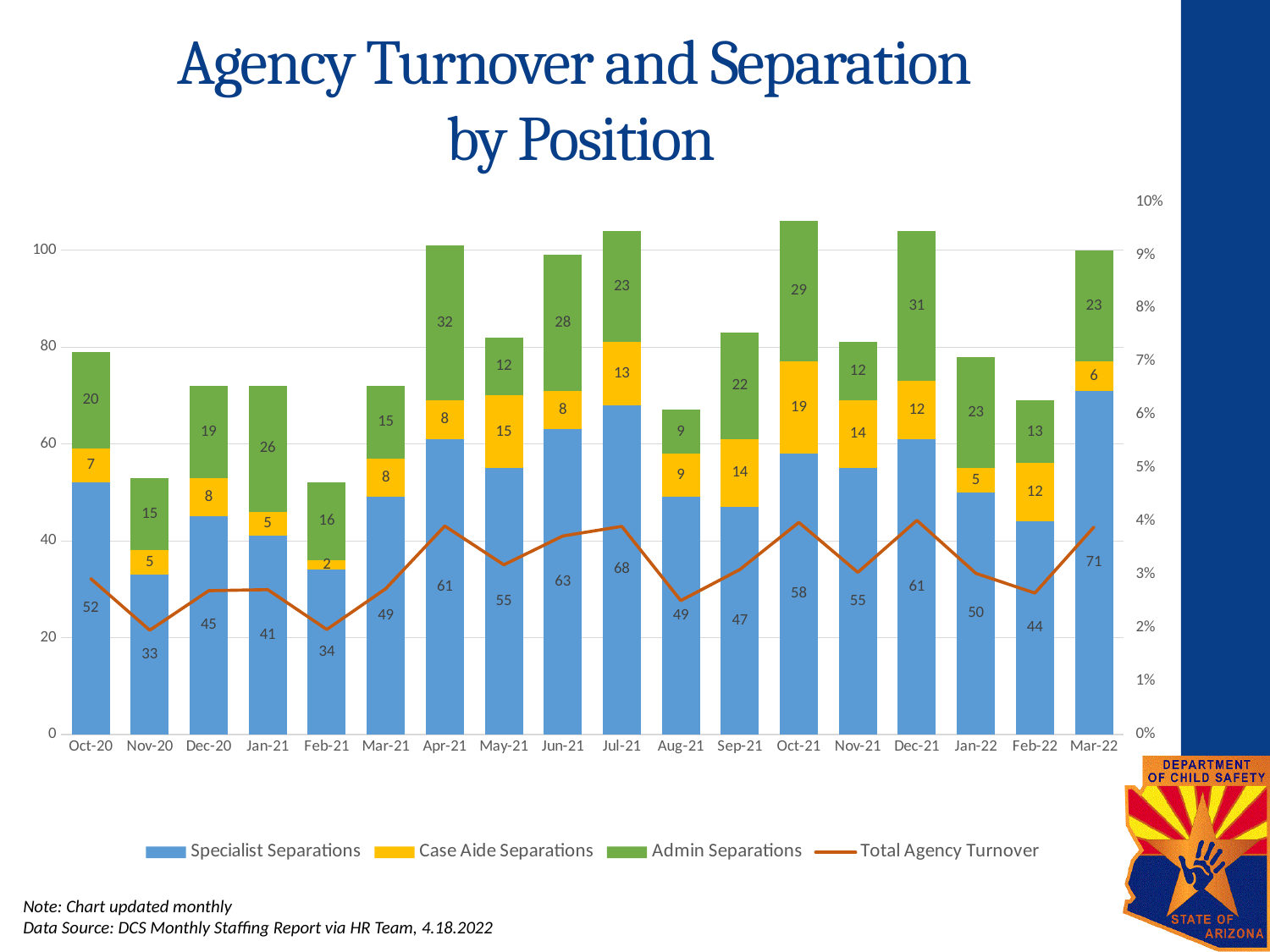
Is the Total Agency Turnover for Nov-20 greater or less than 3%? less Which month has the lowest Specialist Separations? Nov-20 What is the difference between Specialist Separations in Jul-21 and Aug-21? 19 What is the value of Admin Separations for Apr-21? 32 What is the value of Case Aide Separations for Oct-21? 19 What is the value of Specialist Separations for Mar-22? 71 What kind of chart is this? Stacked bar chart with a line Which month has the lowest Case Aide Separations? Feb-21 How many months are shown on the x axis? 18 Which is larger, Admin Separations in Jan-21 or Admin Separations in Dec-20? Jan-21 How many series does the legend list? 4 What is the total of the stacked bar for Oct-21? 106